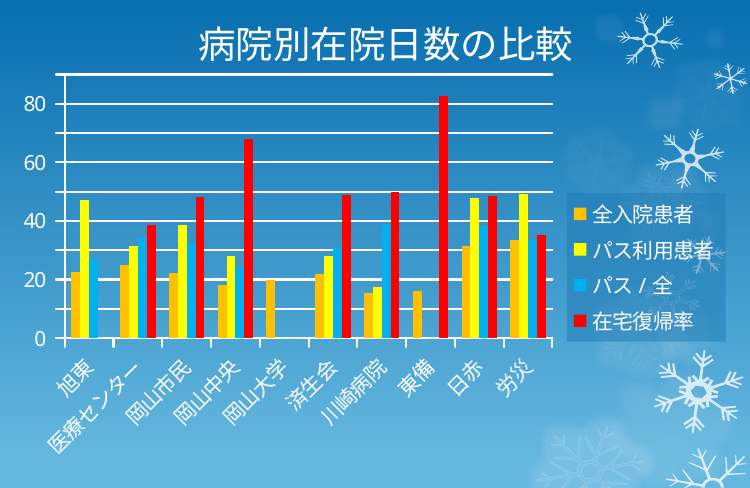
What is the title of the chart? 病院別在院日数の比較 Is the 在宅復帰率 value for 岡山中央 greater or less than 60? greater What kind of chart is shown on the slide? bar chart Which is larger, the 在宅復帰率 value for 岡山中央 or for 済生会? 岡山中央 What colour represents the 在宅復帰率 series in the legend? red Is the パス / 全 value for 川崎病院 greater or less than 20? greater How many hospitals (categories) are shown on the x axis? 10 How many series does the legend list? 4 Which hospital has the highest 在宅復帰率 value? 東備 Is the パス利用患者 value for 旭東 greater or less than 40? greater